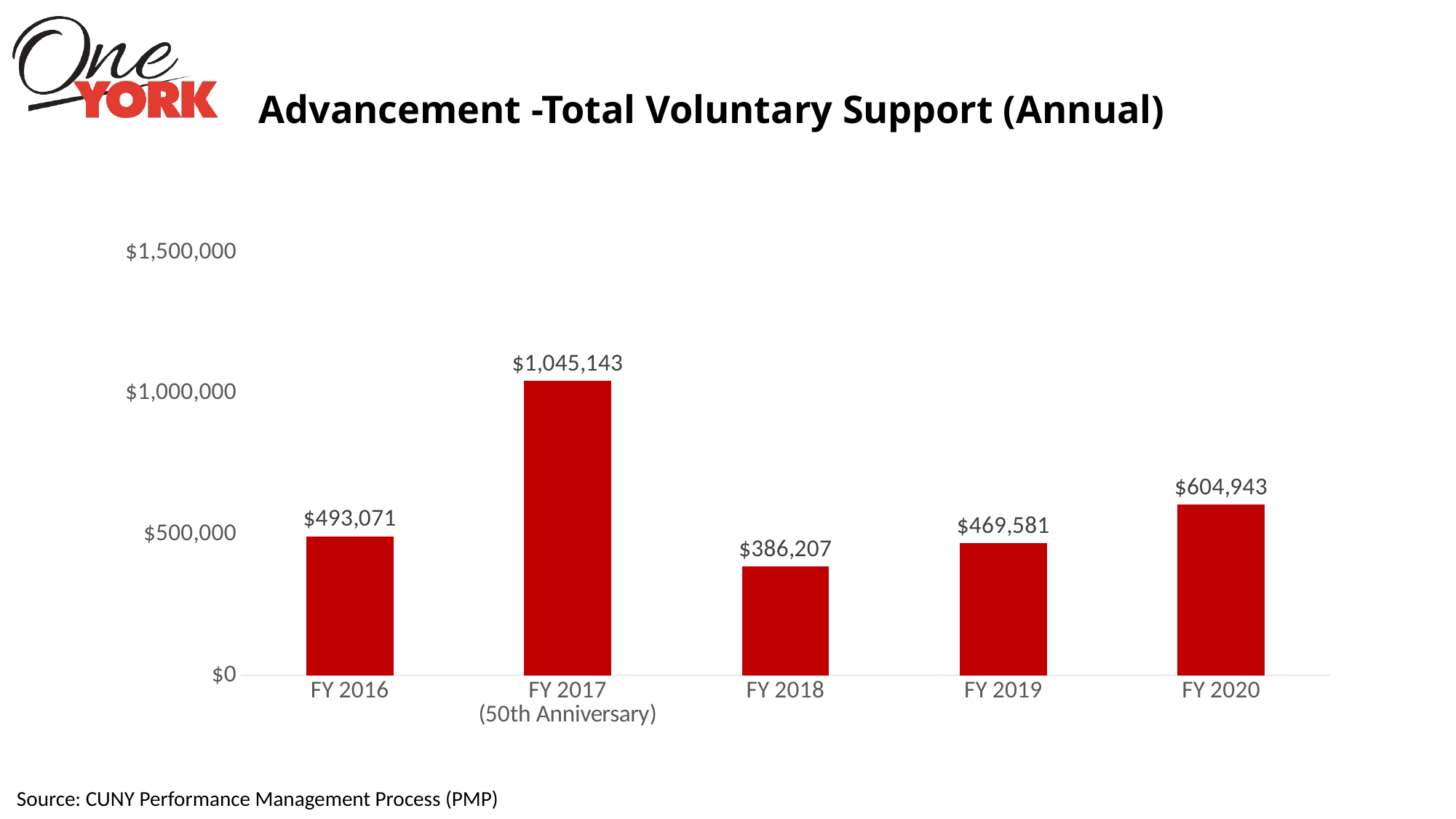
What is the total voluntary support for FY 2016? $493,071 What is the total voluntary support for FY 2020? $604,943 Which fiscal year has the highest total voluntary support? FY 2017 (50th Anniversary) What is the difference in total voluntary support between FY 2020 and FY 2019? $135,362 What is the total voluntary support for FY 2017 (50th Anniversary)? $1,045,143 Is the value for FY 2020 greater or less than $500,000? greater How many fiscal years are shown in the chart? 5 What is the title of the chart? Advancement -Total Voluntary Support (Annual) What is the total voluntary support for FY 2018? $386,207 What kind of chart is shown on the slide? Bar chart Which fiscal year has the lowest total voluntary support? FY 2018 Which is larger, the total voluntary support for FY 2016 or FY 2019? FY 2016